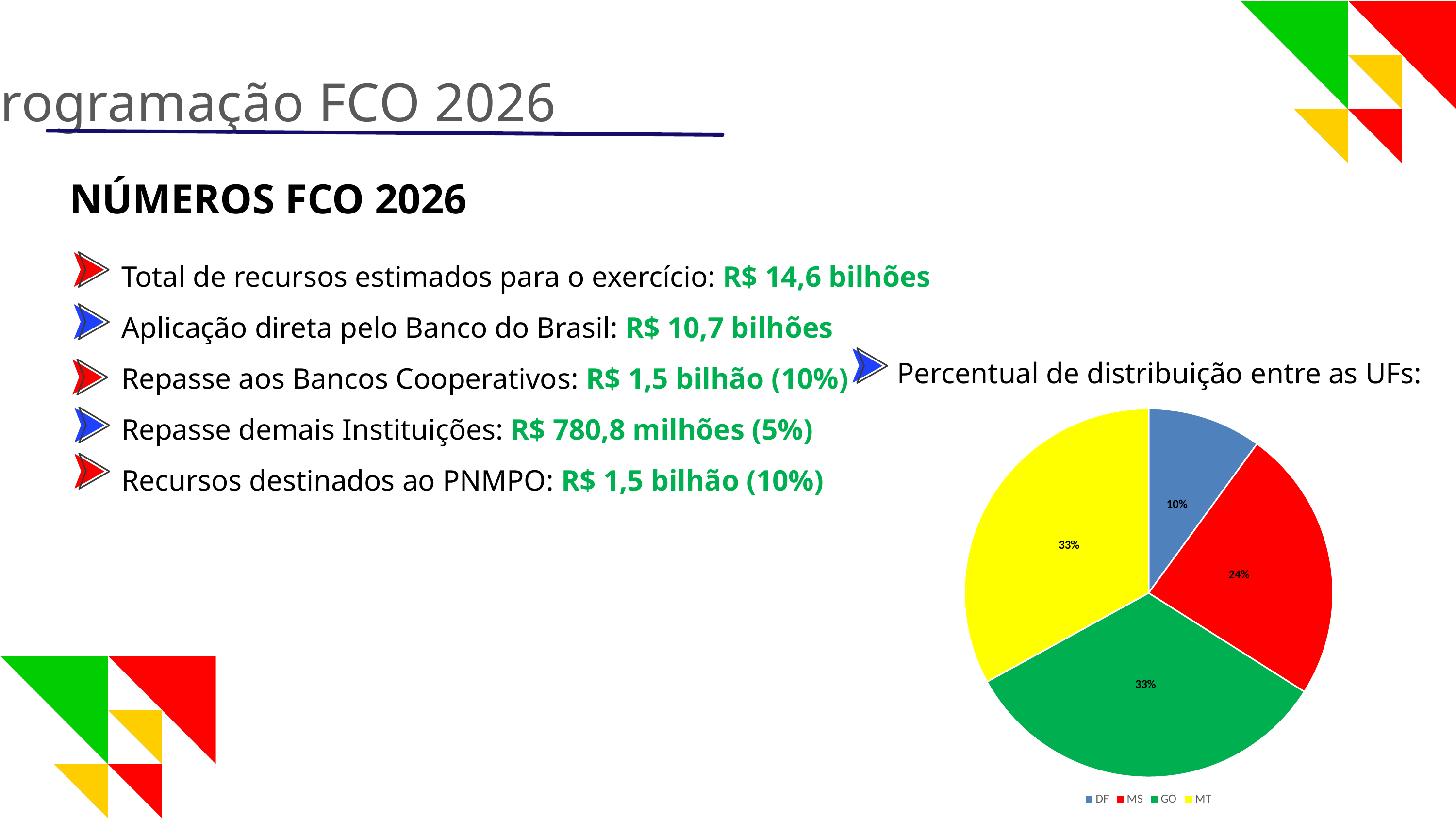
Which colour represents MT in the pie chart? yellow What share of the pie does GO have? 33% What kind of chart is shown on the slide? pie chart Which is larger, the slice for GO or the slice for MS? GO Which UF has the smallest slice of the pie? DF What share of the pie does DF have? 10% What share of the pie does MT have? 33% Which is larger, the slice for MS or the slice for DF? MS What is the difference in percentage points between the MS slice and the DF slice? 14% How many slices does the pie chart have? 4 How many entries does the legend of the pie chart list? 4